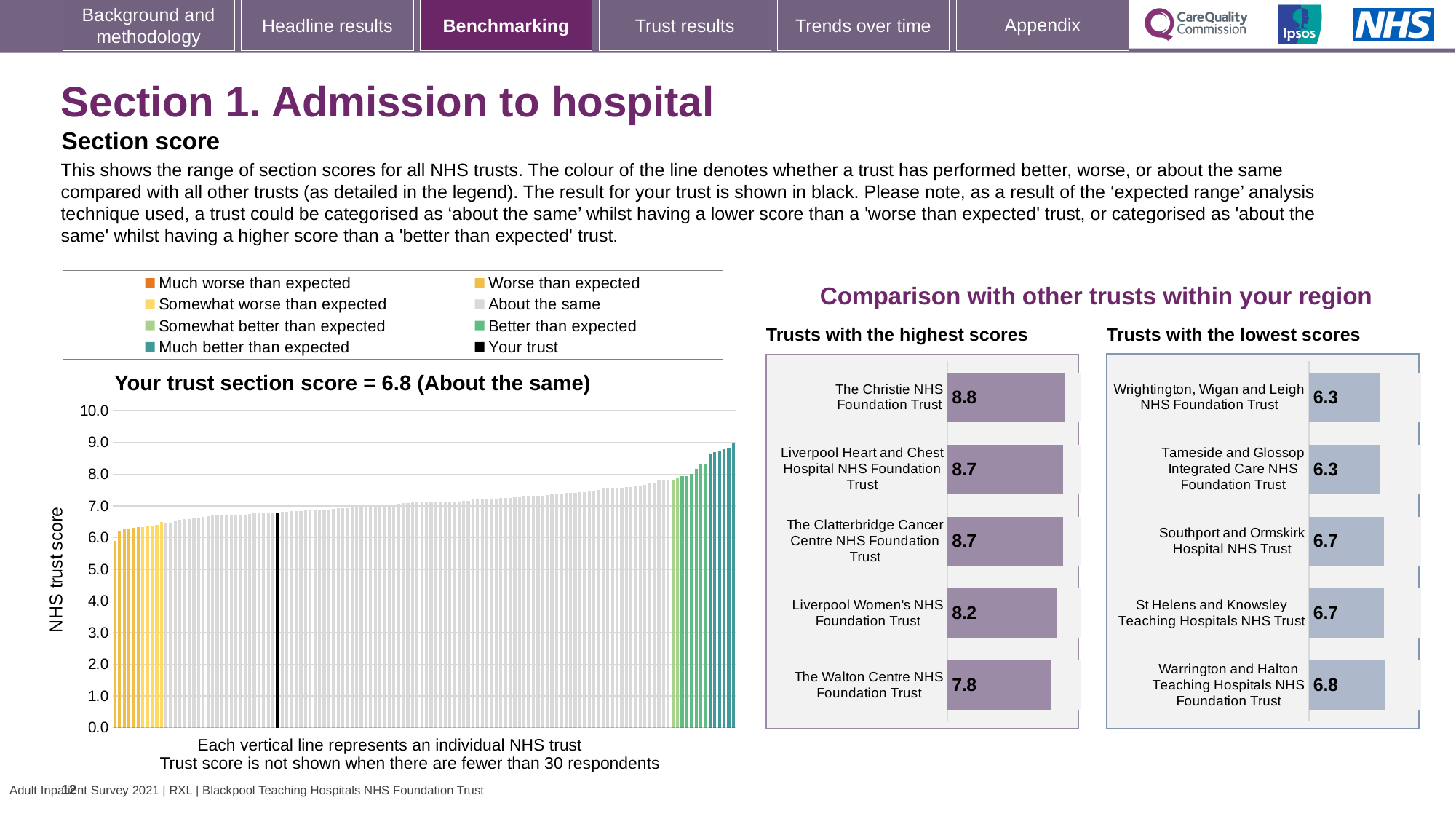
In the 'Your trust section score' chart, do the trust scores rise or fall from left to right? rise In the 'Your trust section score' chart, is the value for your trust greater or less than 5.0? greater In the 'Trusts with the lowest scores' chart, how many trusts are shown? 5 In the 'Trusts with the lowest scores' chart, which has the larger score: Southport and Ormskirk Hospital NHS Trust or Wrightington, Wigan and Leigh NHS Foundation Trust? Southport and Ormskirk Hospital NHS Trust In the 'Trusts with the highest scores' chart, which trust has the lowest score? The Walton Centre NHS Foundation Trust What kind of chart is the 'Your trust section score' chart? bar chart In the 'Trusts with the highest scores' chart, what is the score for Liverpool Women's NHS Foundation Trust? 8.2 In the 'Trusts with the lowest scores' chart, which trust has the highest score? Warrington and Halton Teaching Hospitals NHS Foundation Trust In the 'Trusts with the highest scores' chart, which trust has the highest score? The Christie NHS Foundation Trust In the 'Your trust section score' chart, what is the section score for your trust? 6.8 In the 'Your trust section score' chart, how many entries does the legend list? 8 In the 'Trusts with the highest scores' chart, what is the difference between the scores of The Christie NHS Foundation Trust and The Walton Centre NHS Foundation Trust? 1.0